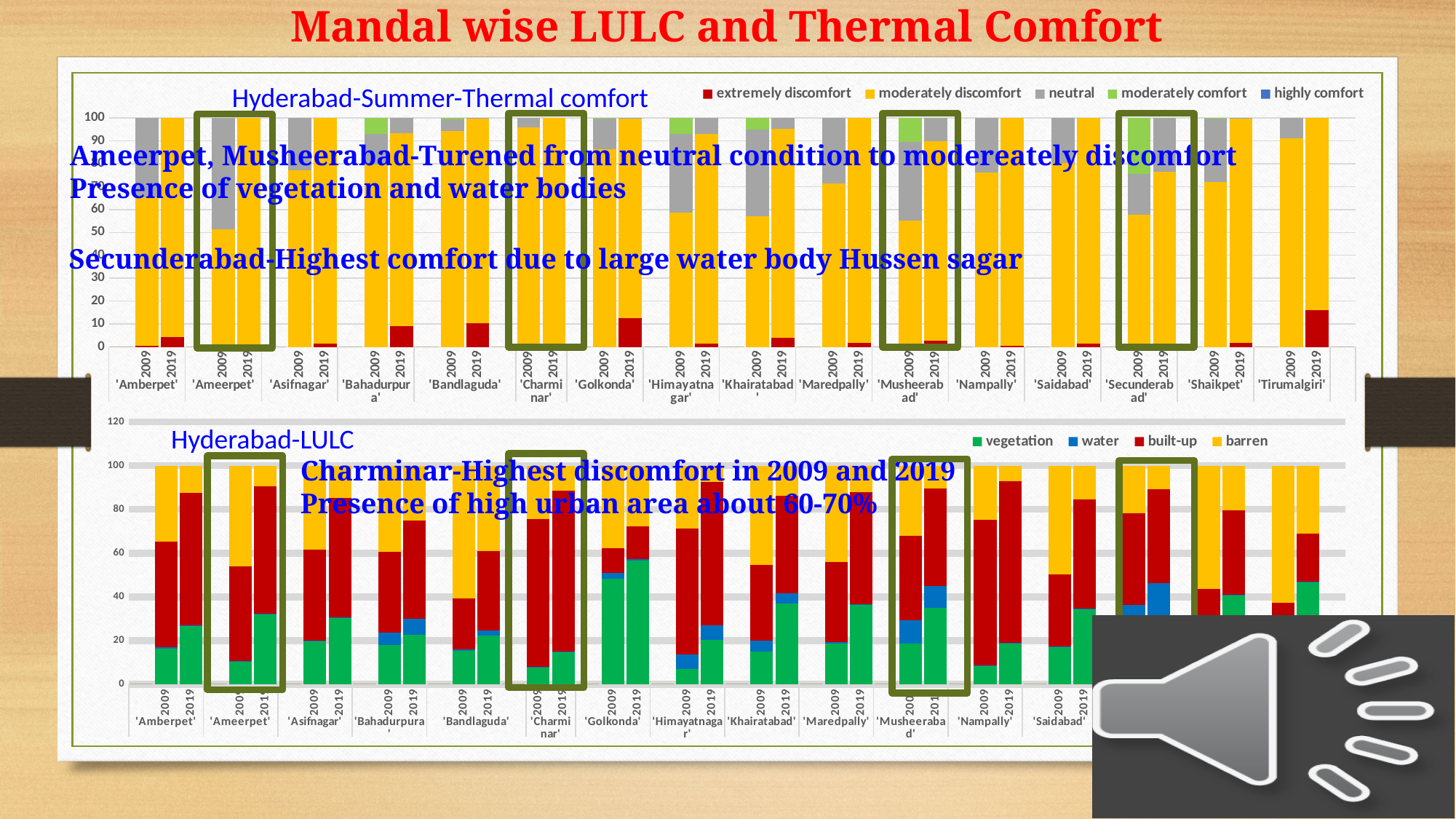
In the Hyderabad-LULC chart, does the top of the built-up segment for Amberpet rise or fall from 2009 to 2019? rise How many series does the legend of the Hyderabad-Summer-Thermal comfort chart list? 5 Which colour represents the neutral series in the Hyderabad-Summer-Thermal comfort chart? Grey What kind of chart is the Hyderabad-Summer-Thermal comfort chart? Stacked bar chart In the Hyderabad-LULC chart, is the vegetation value for Golkonda 2019 greater or less than 40? greater In the Hyderabad-Summer-Thermal comfort chart, is the extremely discomfort value for Tirumalgiri 2019 greater or less than 10? greater How many series does the legend of the Hyderabad-LULC chart list? 4 In the Hyderabad-Summer-Thermal comfort chart, how many mandals are shown on the x axis? 16 What is the title of the lower chart on the slide? Hyderabad-LULC In the Hyderabad-LULC chart, is the vegetation value for Charminar 2009 greater or less than 20? less In the Hyderabad-LULC chart, which year has the larger vegetation share for Ameerpet, 2009 or 2019? 2019 In the Hyderabad-Summer-Thermal comfort chart, which year has the larger extremely discomfort share for Tirumalgiri, 2009 or 2019? 2019